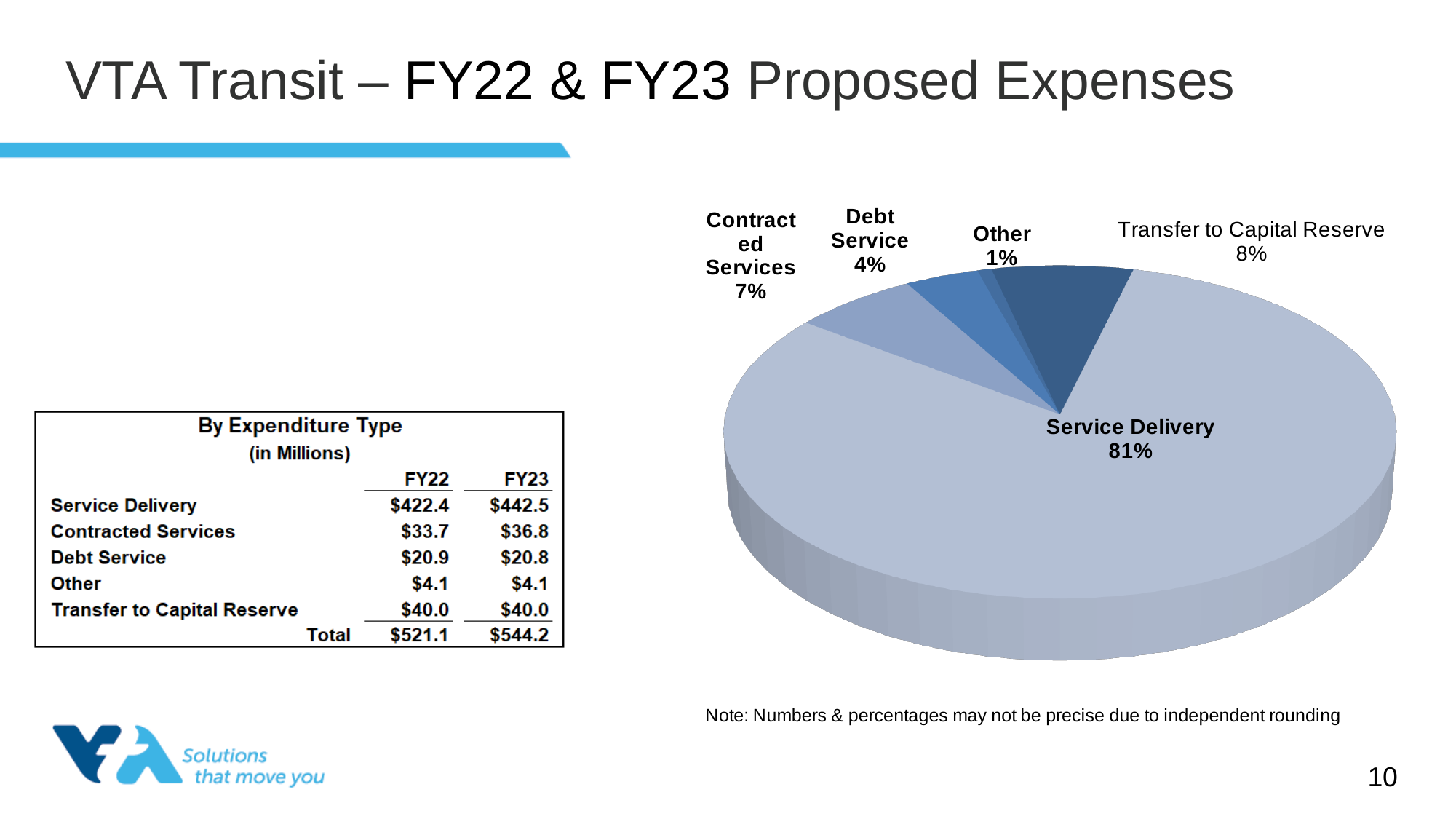
What note appears below the pie chart? Note: Numbers & percentages may not be precise due to independent rounding Which category has the smallest slice in the pie chart? Other What is the difference in percentage points between Transfer to Capital Reserve and Debt Service in the pie chart? 4 percentage points What percentage is shown for Other in the pie chart? 1% Which category has the largest slice in the pie chart? Service Delivery What kind of chart is shown on the slide? Pie chart What percentage is shown for Debt Service in the pie chart? 4% What percentage is shown for Transfer to Capital Reserve in the pie chart? 8% How many slices does the pie chart have? 5 In the pie chart, which is larger: Transfer to Capital Reserve or Contracted Services? Transfer to Capital Reserve What share of the pie chart does Service Delivery represent? 81% What percentage is shown for Contracted Services in the pie chart? 7%